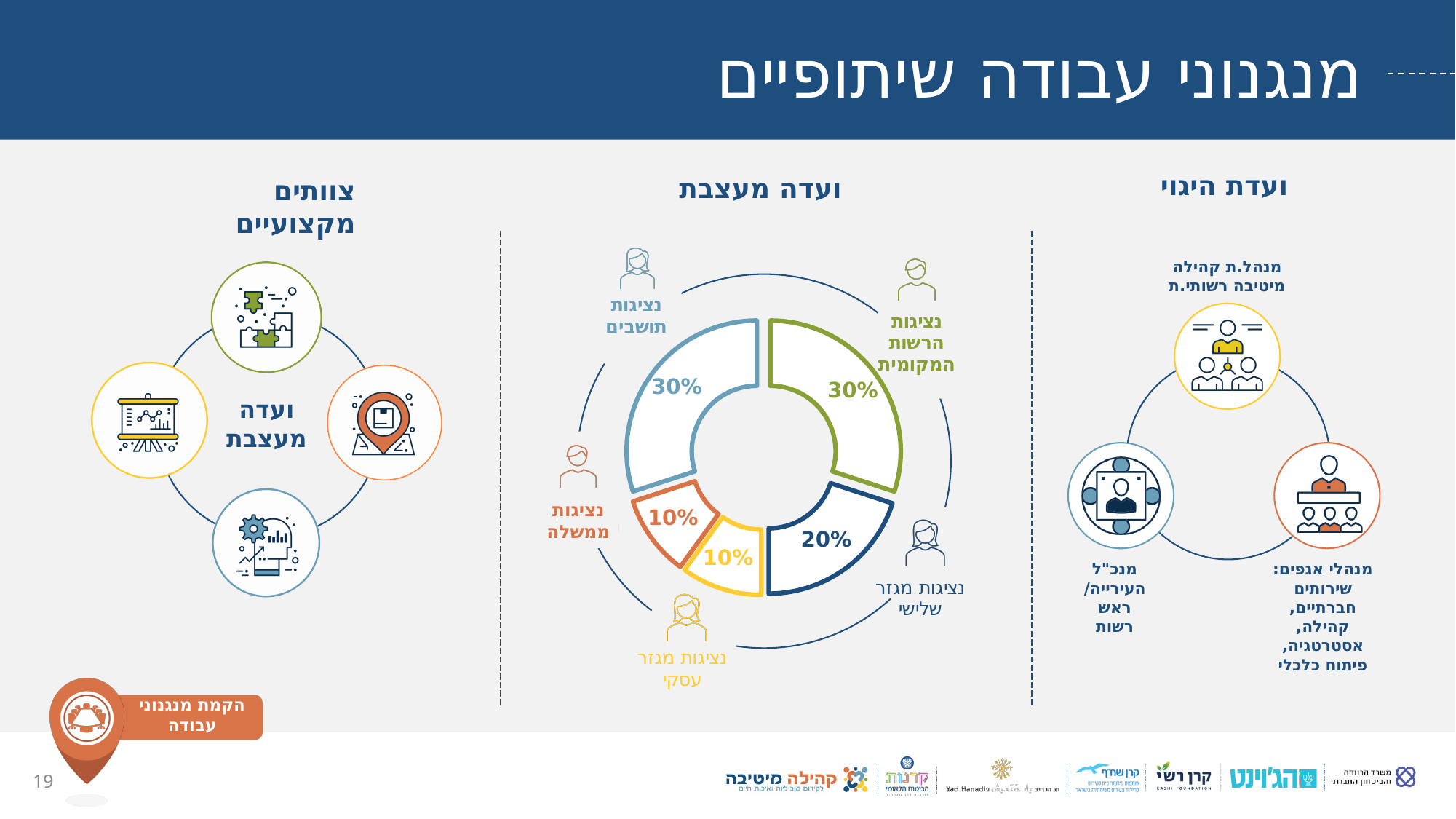
How many segments does the donut chart have? 5 In the donut chart, what share is shown for נציגות הרשות המקומית? 30% In the donut chart, what share is shown for נציגות תושבים? 30% In the donut chart, what is the combined share of נציגות ממשלה and נציגות מגזר עסקי? 20% What kind of chart is shown in the middle section of the slide under the heading ועדה מעצבת? Donut (pie) chart In the donut chart, which is larger: נציגות מגזר שלישי or נציגות ממשלה? נציגות מגזר שלישי In the donut chart, what share is shown for נציגות ממשלה? 10% In the donut chart, what share is shown for נציגות מגזר עסקי? 10% In the donut chart, which two groups share the largest value? נציגות הרשות המקומית and נציגות תושבים In the donut chart, what share is shown for נציגות מגזר שלישי? 20% In the donut chart, what is the difference between the share for נציגות הרשות המקומית and the share for נציגות מגזר שלישי? 10% What colour is the segment for נציגות מגזר שלישי in the donut chart? Dark blue